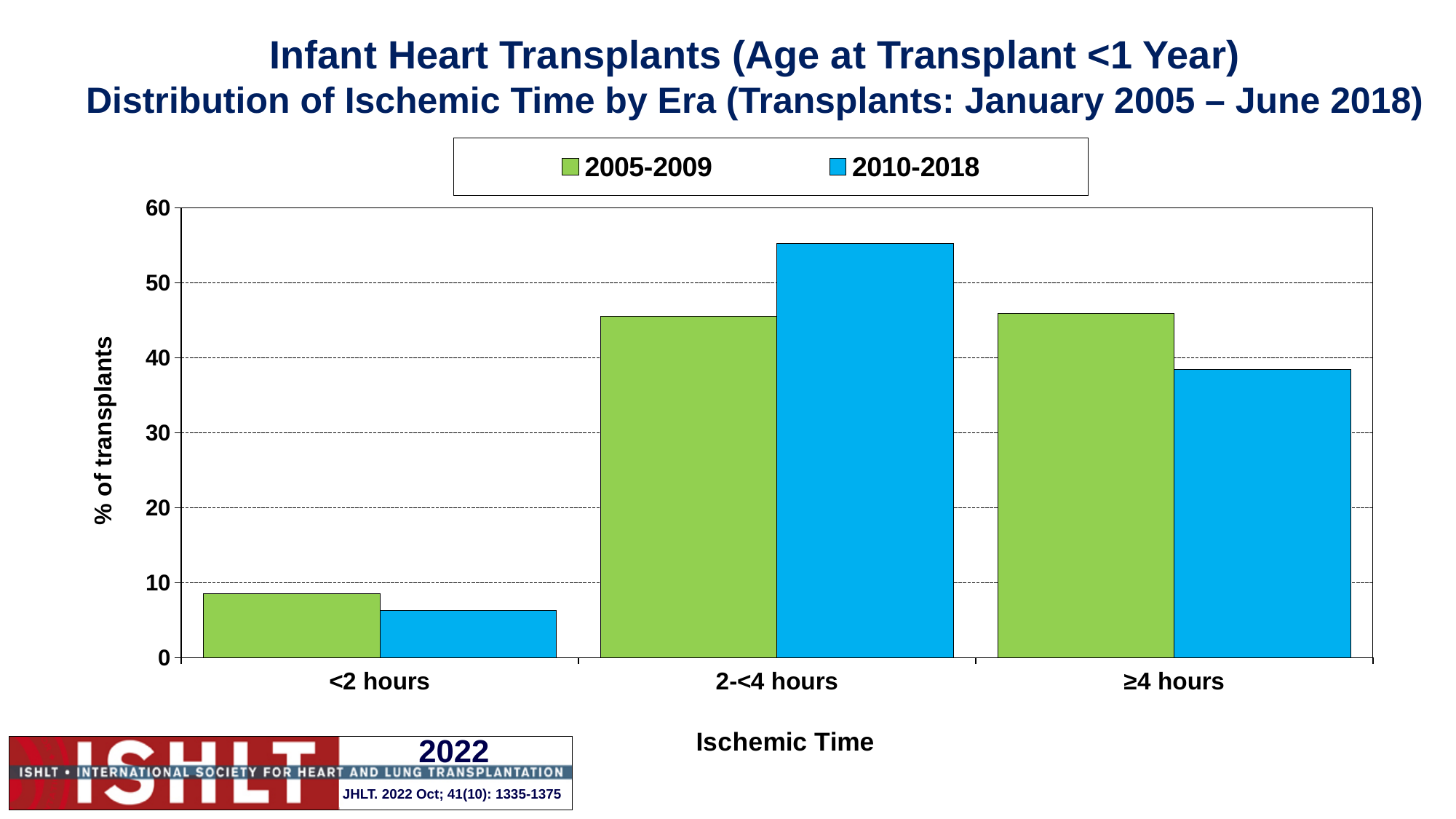
How many ischemic time categories are shown on the x axis? 3 How many series does the legend list? 2 For 2-<4 hours, which era has the larger value, 2005-2009 or 2010-2018? 2010-2018 Is the value for 2005-2009 at <2 hours greater or less than 10? less Is the value for 2010-2018 at 2-<4 hours greater or less than 50? greater Which ischemic time category has the highest value for 2010-2018? 2-<4 hours Which ischemic time category has the lowest value for 2005-2009? <2 hours Which ischemic time category has the lowest value for 2010-2018? <2 hours What kind of chart is shown on the slide? bar chart Is the value for 2010-2018 at ≥4 hours greater or less than 40? less What is the label of the y axis? % of transplants For ≥4 hours, which era has the larger value, 2005-2009 or 2010-2018? 2005-2009